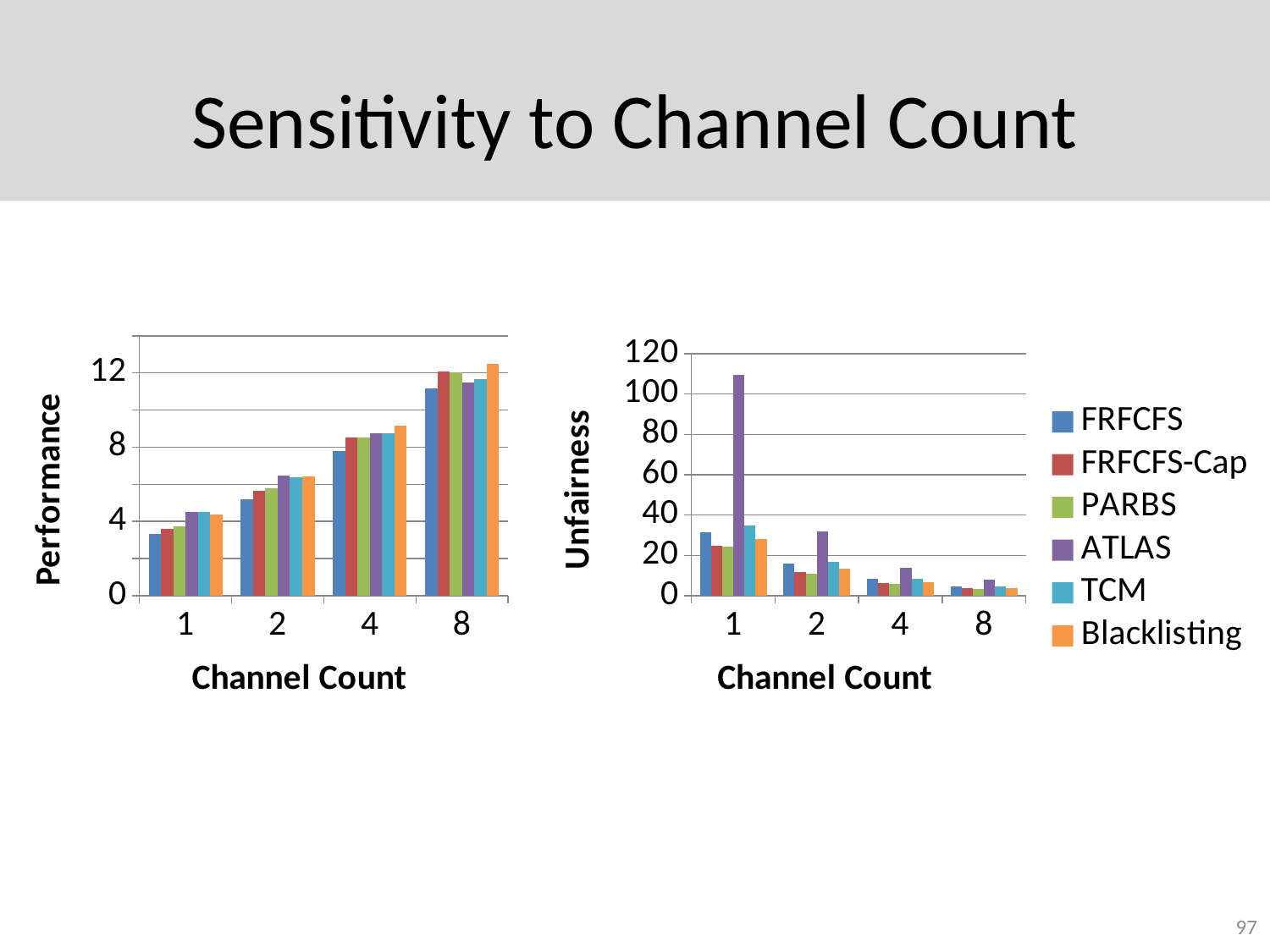
In the Performance chart on the left, is the value for FRFCFS at channel count 1 greater or less than 4? less In the Unfairness chart on the right, which series has the highest value at channel count 1? ATLAS In the Performance chart on the left, is the value for Blacklisting at channel count 4 greater or less than 8? greater How many series does the legend list? 6 In the Performance chart on the left, do the values rise or fall as the channel count increases? Rise In the Unfairness chart on the right, how many channel count categories are shown on the x axis? 4 What kind of chart is the Performance chart on the left? Bar chart What is the x-axis title of the Performance chart on the left? Channel Count In the Unfairness chart on the right, is the value for FRFCFS at channel count 1 greater or less than 40? less In the Unfairness chart on the right, which is larger at channel count 2: ATLAS or PARBS? ATLAS In the Unfairness chart on the right, do the values generally rise or fall as the channel count increases? Fall